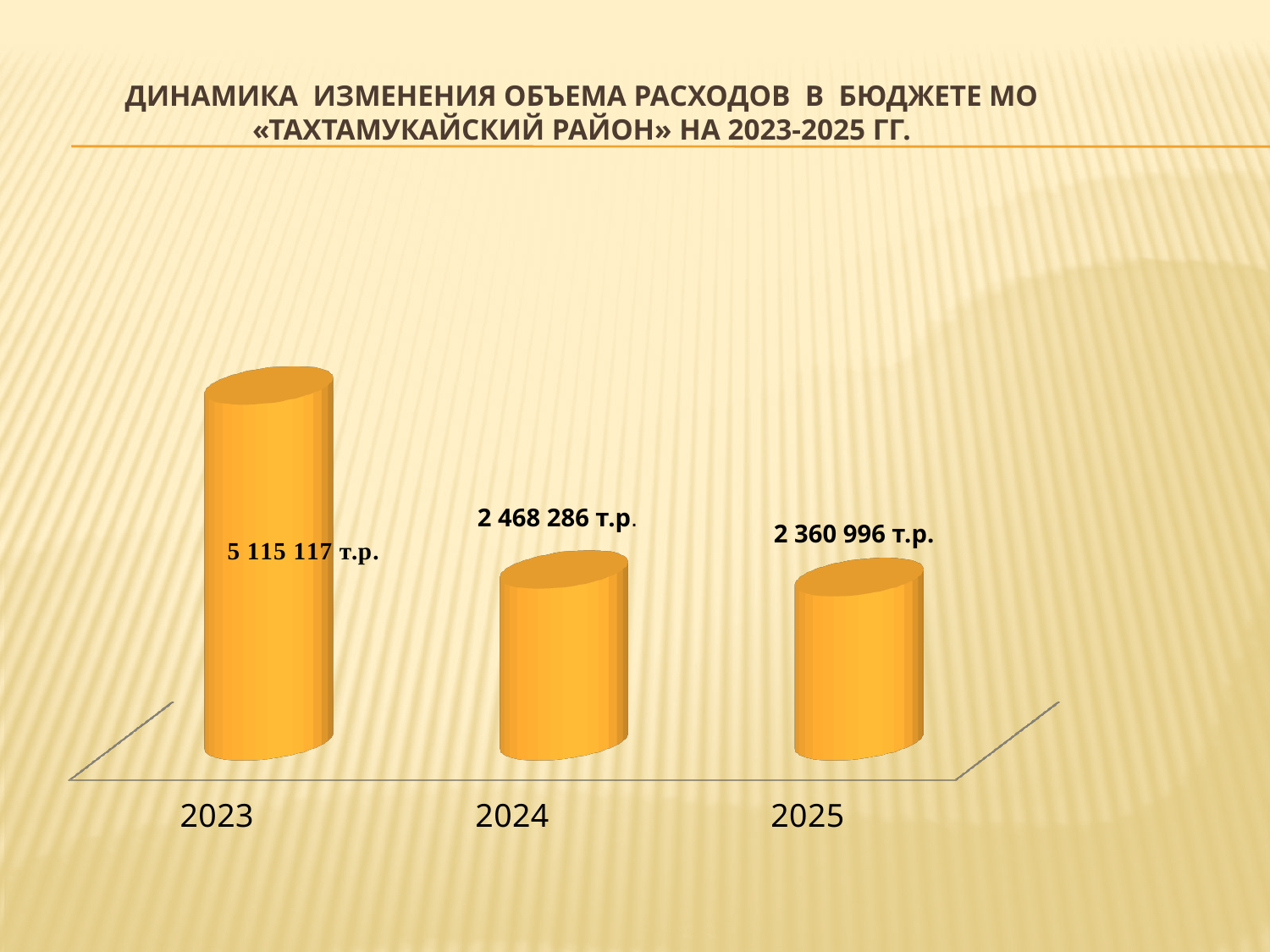
How many years are shown on the chart? 3 Which year has the lowest expenditure volume? 2025 What is the value for 2024? 2 468 286 т.р. What is the difference between the values for 2023 and 2025? 2 754 121 т.р. Do the values rise or fall from 2023 to 2025? Fall What is the difference between the values for 2023 and 2024? 2 646 831 т.р. What kind of chart is shown on the slide? Bar chart What is the difference between the values for 2024 and 2025? 107 290 т.р. What is the value for 2025? 2 360 996 т.р. Which year has the highest expenditure volume? 2023 What is the value for 2023? 5 115 117 т.р. Which is larger, the value for 2024 or the value for 2025? 2024